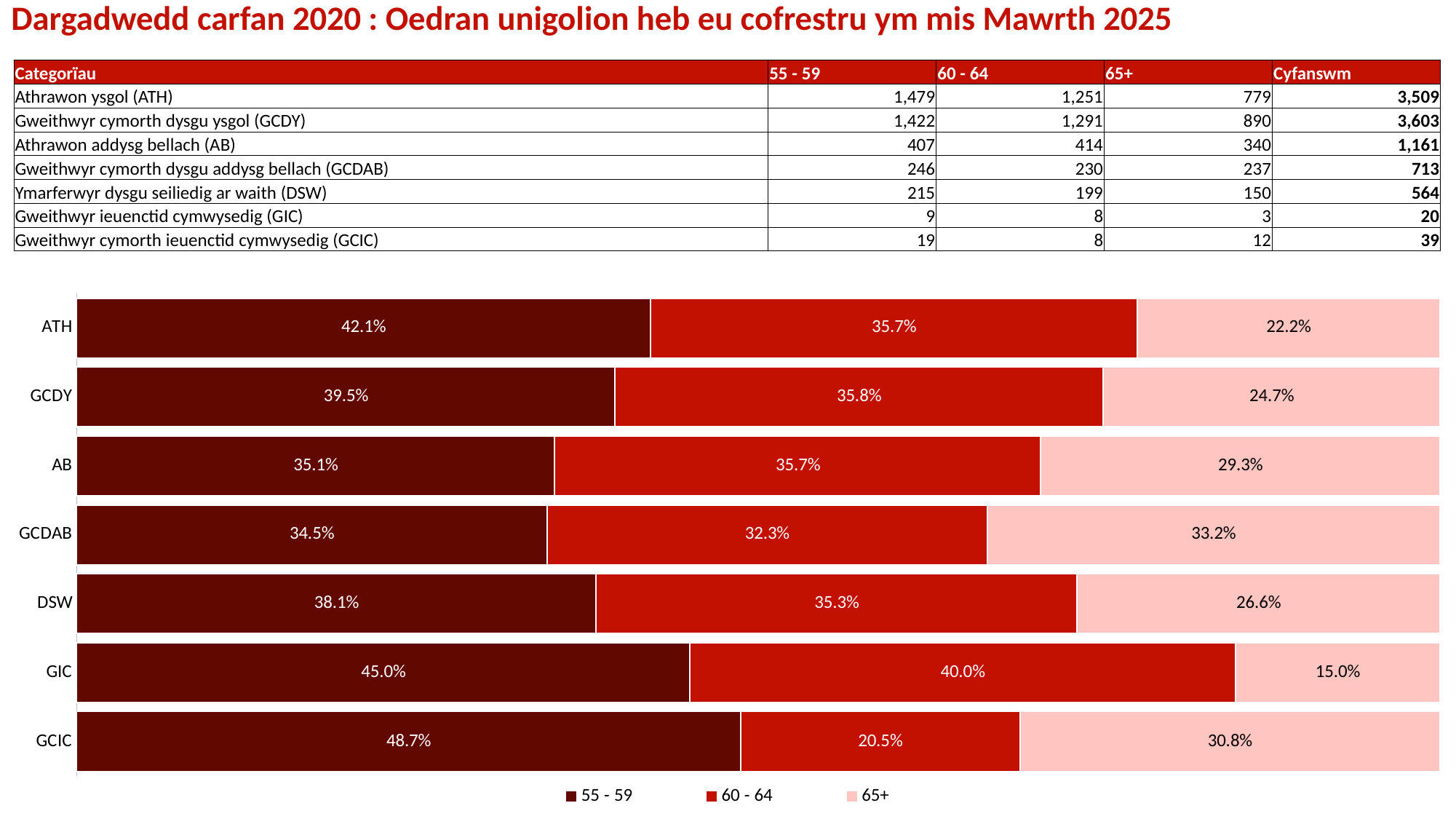
Which category has the highest 55 - 59 share on the chart? GCIC What is the 55 - 59 share for GCIC on the chart? 48.7% On the chart, which is larger: the 65+ share for AB or the 65+ share for DSW? AB What is the 60 - 64 share for GCDAB on the chart? 32.3% What is the 65+ share for GIC on the chart? 15.0% How many categories are plotted on the chart? 7 What kind of chart is shown on the slide? Stacked bar chart On the chart, what is the difference between the 55 - 59 share and the 65+ share for ATH? 19.9 percentage points Which series is shown in the lightest pink colour on the chart? 65+ Which category has the lowest 65+ share on the chart? GIC What is the total of the three segments in the GCDY bar on the chart? 100.0% How many series does the chart legend list? 3